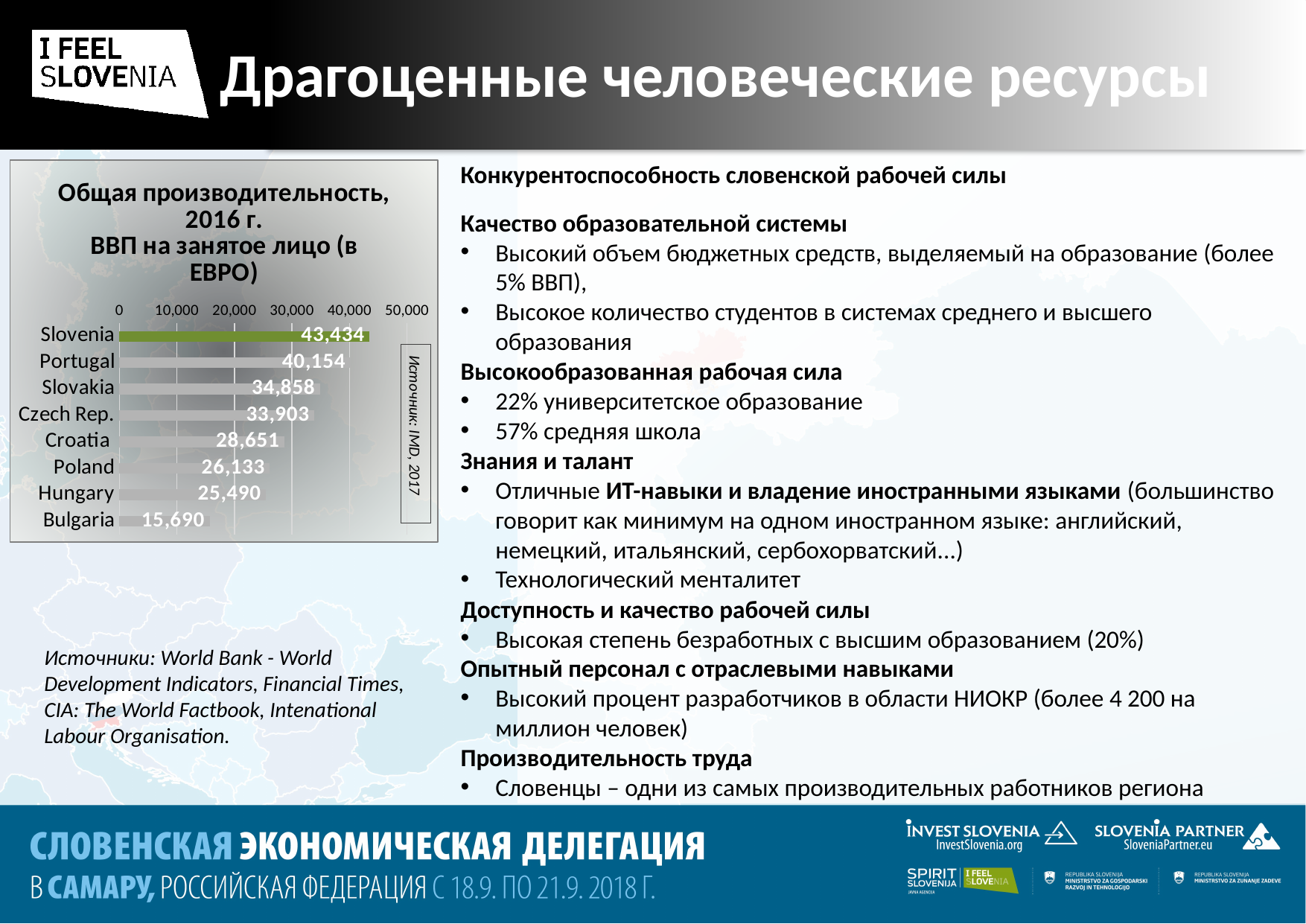
Is the value for Portugal greater or less than 30,000? greater What is the GDP per employed person shown for Slovenia? 43,434 What kind of chart is shown on the slide? Bar chart Which has a larger value, Croatia or Slovakia? Slovakia Which country has the highest value in the chart? Slovenia Which country has the lowest value in the chart? Bulgaria What is the difference between the values for Poland and Hungary? 643 What is the title of the chart? Общая производительность, 2016 г. ВВП на занятое лицо (в ЕВРО) How many countries are shown in the chart? 8 What value is shown for Czech Rep. in the chart? 33,903 What is the difference between the values for Slovenia and Portugal? 3,280 What value is shown for Bulgaria in the chart? 15,690